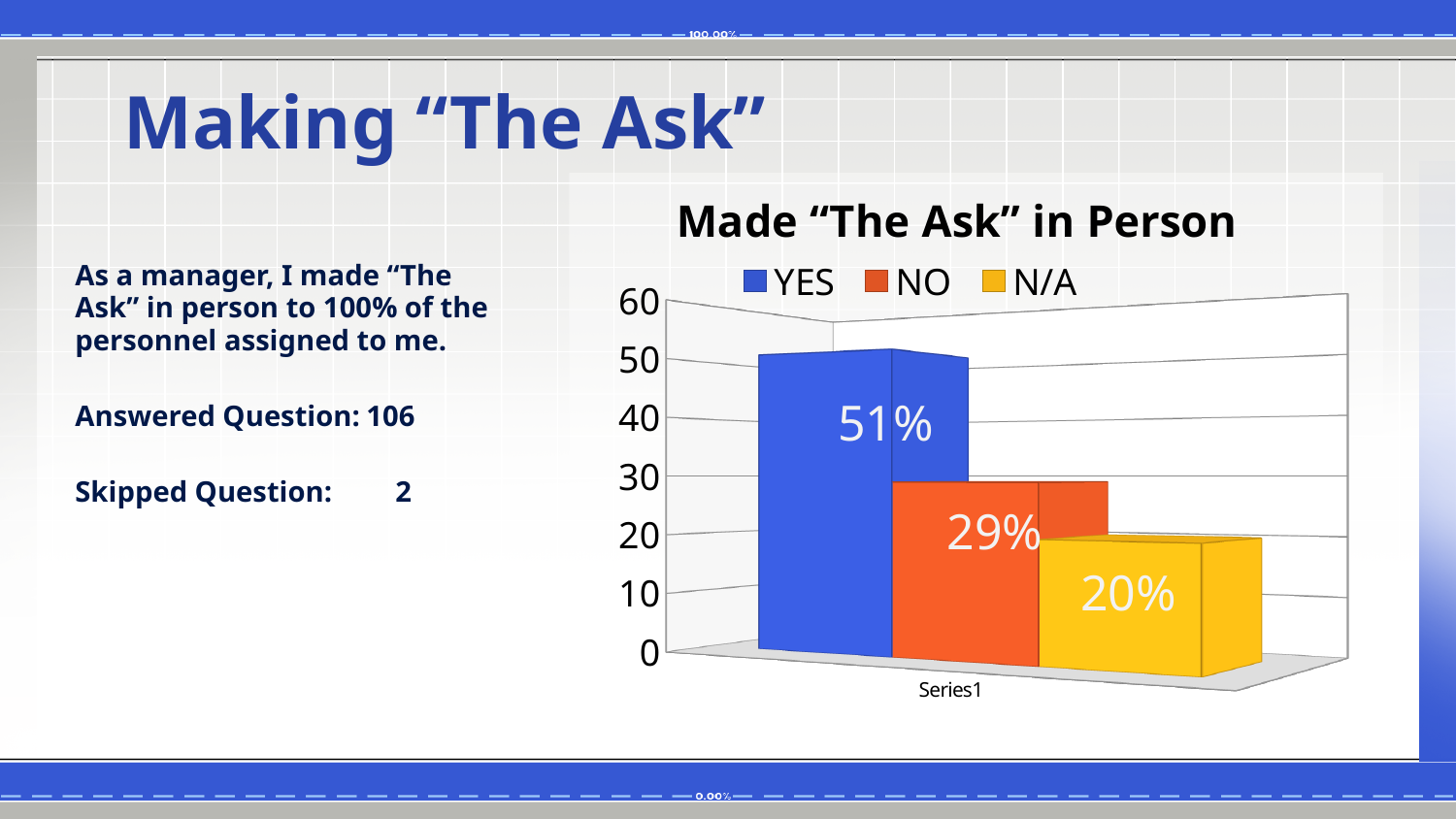
What is the value for NO in the chart? 29% Is the value for YES greater or less than 40? greater How many entries does the legend list? 3 What is the title of the chart? Made "The Ask" in Person What is the difference between the NO and N/A values? 9% What kind of chart is shown on the slide? bar chart What is the value for N/A in the chart? 20% What is the difference between the YES and NO values? 22% Which category has the highest value in the chart? YES Which category has the lowest value in the chart? N/A What is the value for YES in the chart? 51% Which is larger, the value for NO or the value for N/A? NO